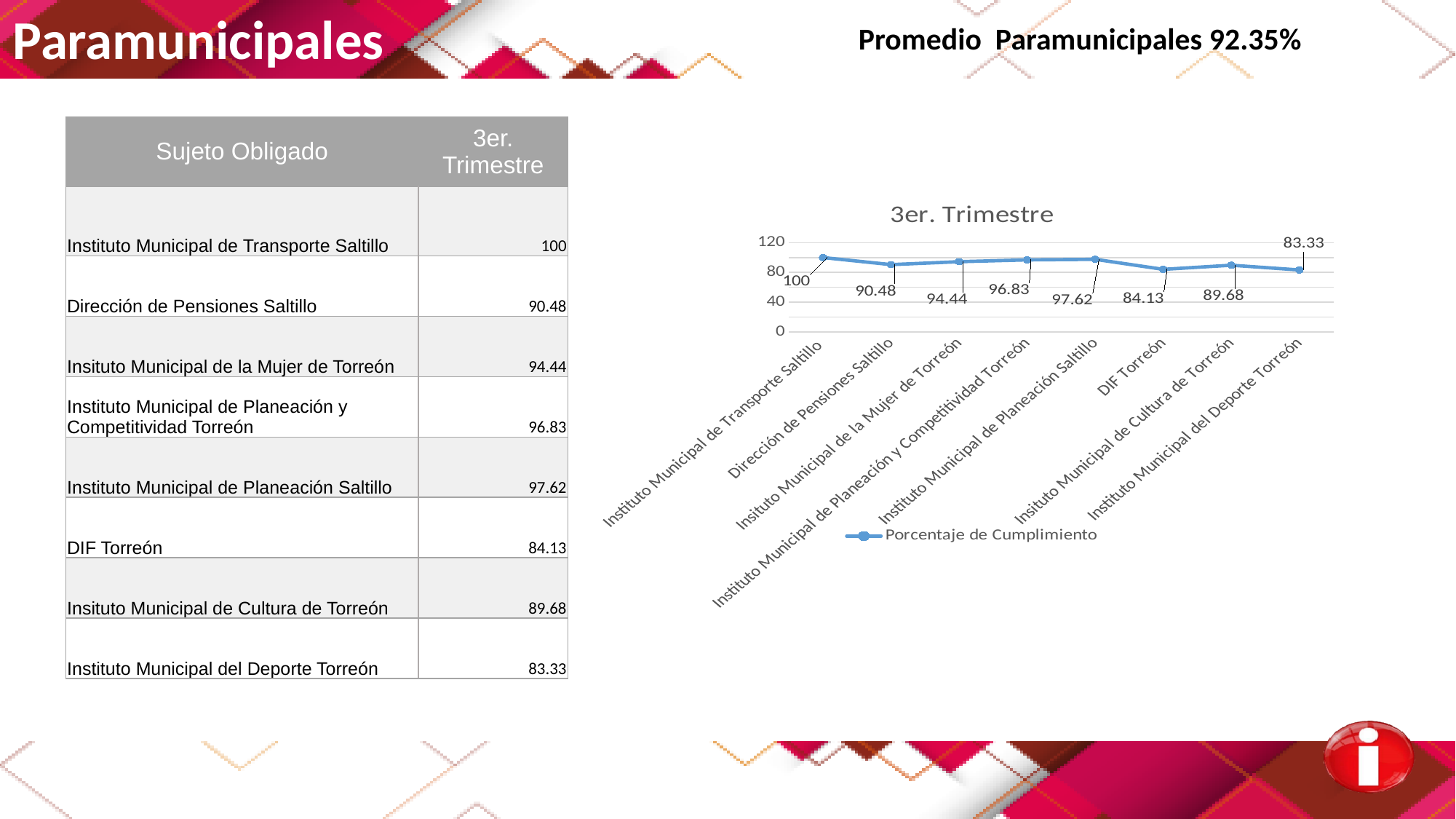
Which category has the lowest value in the chart? Instituto Municipal del Deporte Torreón What is the value for Instituto Municipal de Transporte Saltillo in the chart? 100 What is the value for DIF Torreón in the chart? 84.13 How many categories are plotted in the chart? 8 What is the value for Instituto Municipal de Planeación Saltillo in the chart? 97.62 What is the difference between the values for Instituto Municipal de Transporte Saltillo and Instituto Municipal del Deporte Torreón? 16.67 What kind of chart is shown on the slide? line chart Is the value for DIF Torreón greater or less than 80? greater Which category has the highest value in the chart? Instituto Municipal de Transporte Saltillo Which is larger, the value for Dirección de Pensiones Saltillo or the value for Insituto Municipal de Cultura de Torreón? Dirección de Pensiones Saltillo What is the title of the chart? 3er. Trimestre How many series does the chart legend list? 1